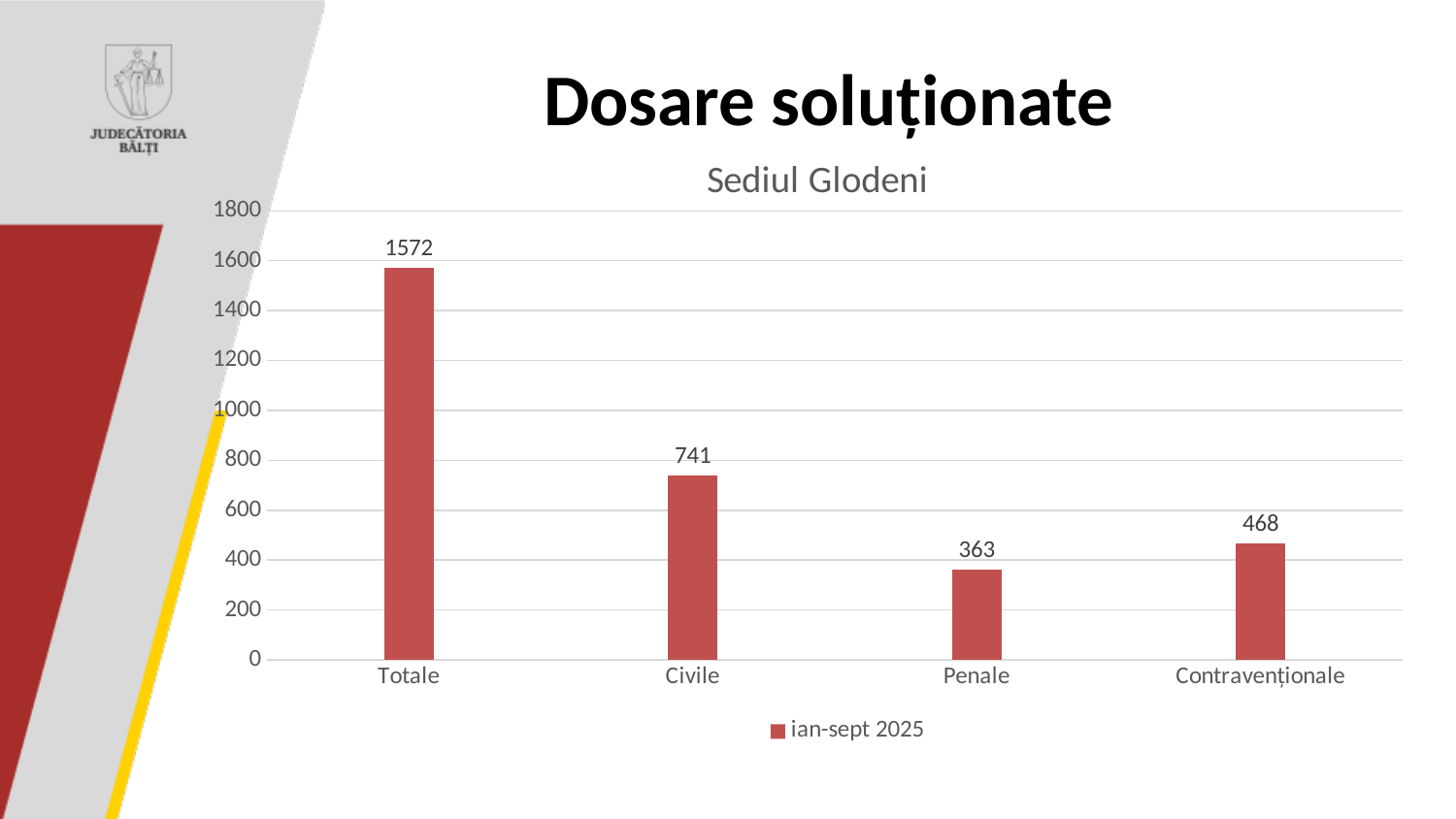
What is the value for Totale? 1572 What is the value for Contravenționale? 468 What is the difference between the values for Civile and Penale? 378 What is the value for Penale? 363 What series name does the legend show? ian-sept 2025 Which is larger, the value for Contravenționale or the value for Penale? Contravenționale Which category has the lowest value? Penale What kind of chart is shown on the slide? bar chart Which category has the highest value? Totale How many categories are shown on the x axis? 4 What is the value for Civile? 741 Is the value for Civile greater or less than 800? less